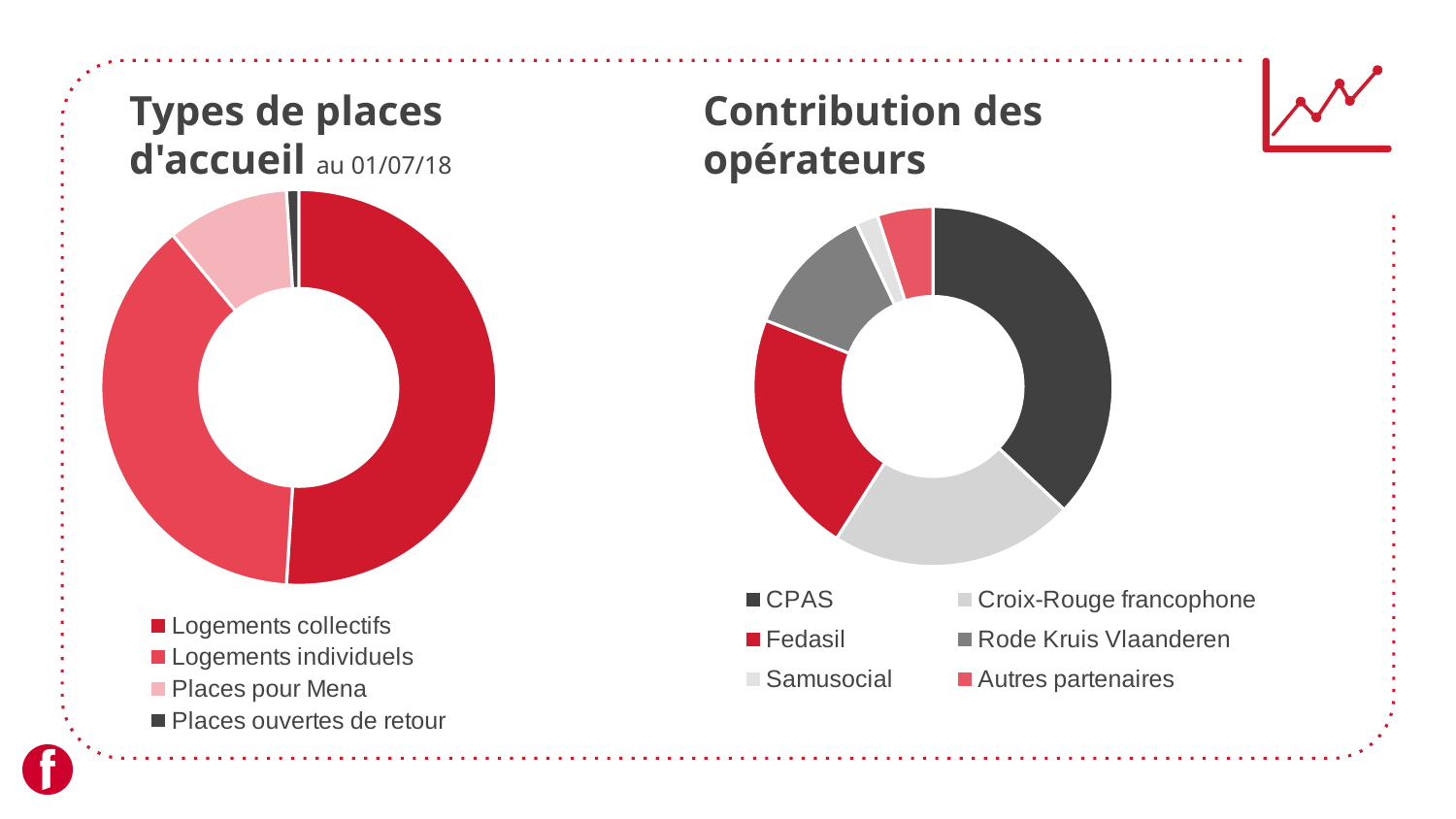
In the 'Types de places d'accueil' chart, which slice is larger: Logements individuels or Places pour Mena? Logements individuels What kind of chart is the 'Types de places d'accueil' chart on the left? Doughnut chart In the 'Contribution des opérateurs' chart, which operator has the largest slice? CPAS In the 'Types de places d'accueil' chart, which category has the largest slice? Logements collectifs What date is given in the title of the 'Types de places d'accueil' chart? 01/07/18 In the 'Contribution des opérateurs' chart, which slice is larger: Rode Kruis Vlaanderen or Autres partenaires? Rode Kruis Vlaanderen In the 'Contribution des opérateurs' chart, which operator has the smallest slice? Samusocial In the 'Contribution des opérateurs' chart, how many categories does the legend list? 6 In the 'Types de places d'accueil' chart, how many categories does the legend list? 4 In the 'Types de places d'accueil' chart, which category has the smallest slice? Places ouvertes de retour What kind of chart is the 'Contribution des opérateurs' chart on the right? Doughnut chart